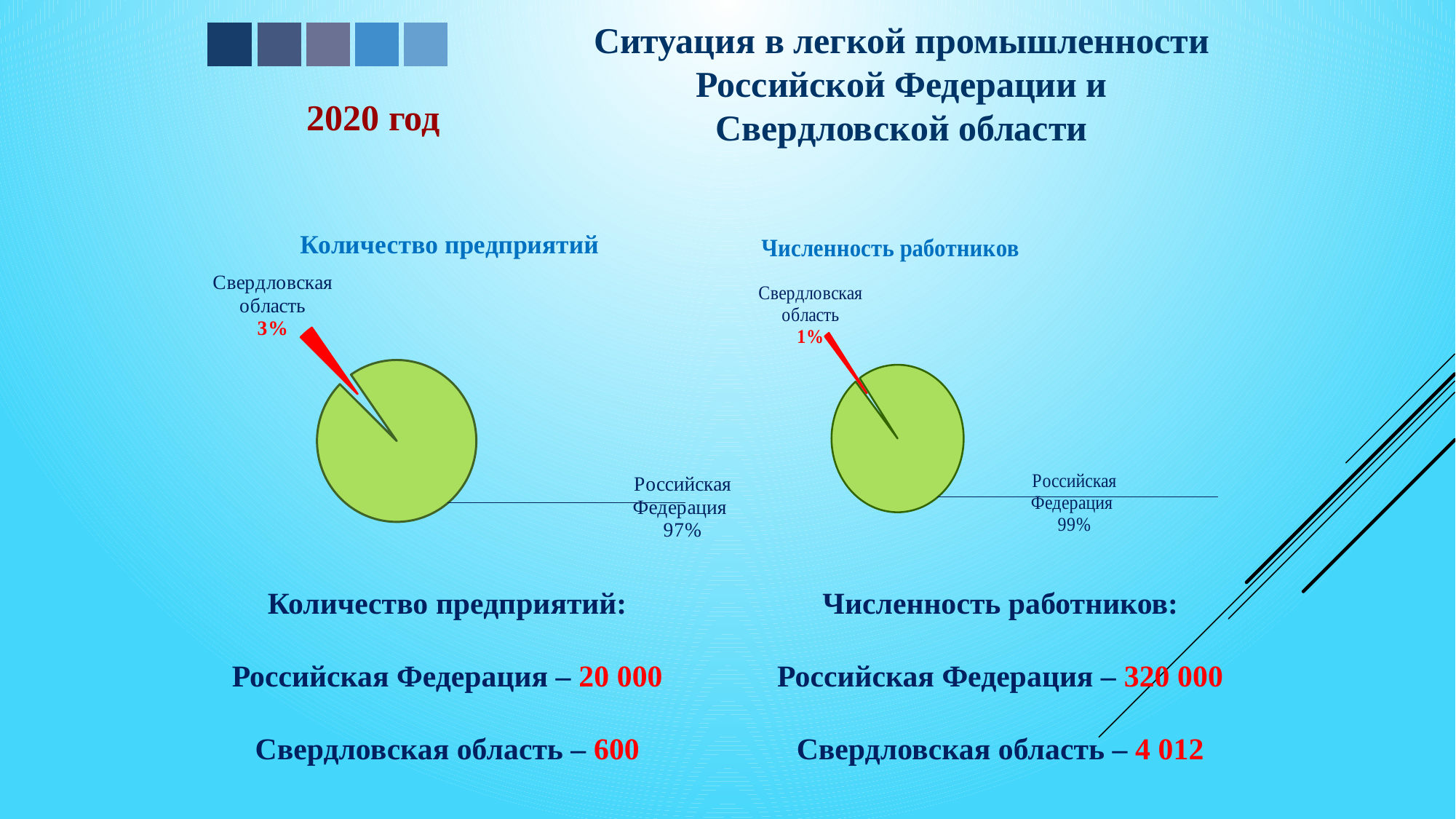
In the 'Численность работников' chart, what is the difference in percentage points between Российская Федерация and Свердловская область? 98 In the 'Количество предприятий' chart, what is the difference in percentage points between Российская Федерация and Свердловская область? 94 In the 'Количество предприятий' chart, what share does Российская Федерация have? 97% In the 'Количество предприятий' chart, what share does Свердловская область have? 3% In the 'Численность работников' chart, which slice is the smallest? Свердловская область What kind of chart is the 'Количество предприятий' chart? Pie chart In the 'Численность работников' chart, what share does Свердловская область have? 1% How many slices does the 'Численность работников' pie chart have? 2 Which is larger: the Свердловская область share in the 'Количество предприятий' chart or in the 'Численность работников' chart? Количество предприятий In the 'Количество предприятий' chart, what colour is the Свердловская область slice? Red In the 'Количество предприятий' chart, which slice is the largest? Российская Федерация In the 'Численность работников' chart, what share does Российская Федерация have? 99%